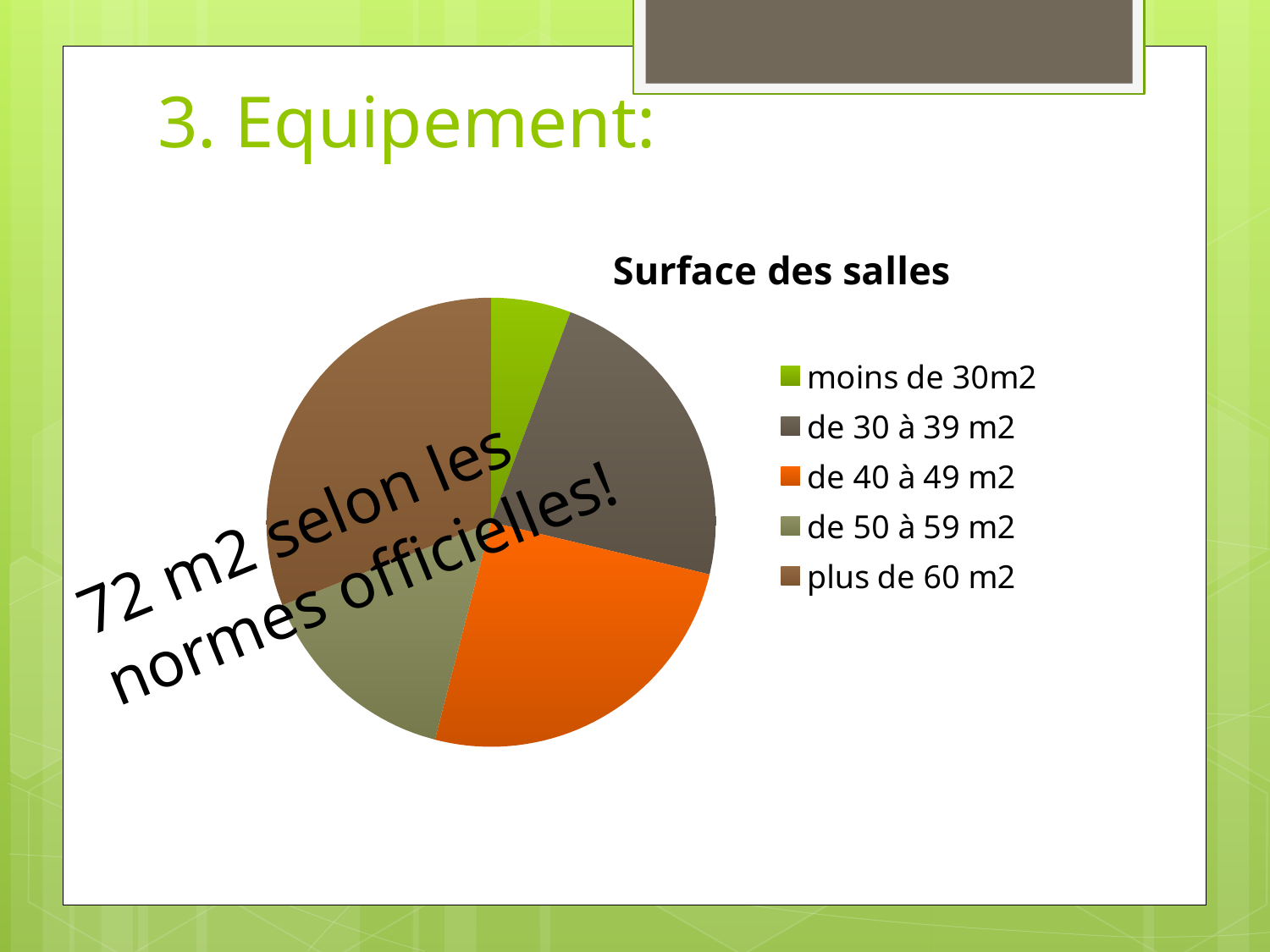
Which category has the smallest slice in the pie chart? moins de 30m2 Which slice is larger: 'plus de 60 m2' or 'de 50 à 59 m2'? plus de 60 m2 What colour is the slice for 'de 40 à 49 m2' in the pie chart? orange What kind of chart is shown on the slide? pie chart How many categories (slices) does the pie chart have? 5 Which slice is larger: 'de 50 à 59 m2' or 'moins de 30m2'? de 50 à 59 m2 Which category has the largest slice in the pie chart? plus de 60 m2 Which slice is larger: 'moins de 30m2' or 'de 30 à 39 m2'? de 30 à 39 m2 What is the title of the pie chart? Surface des salles